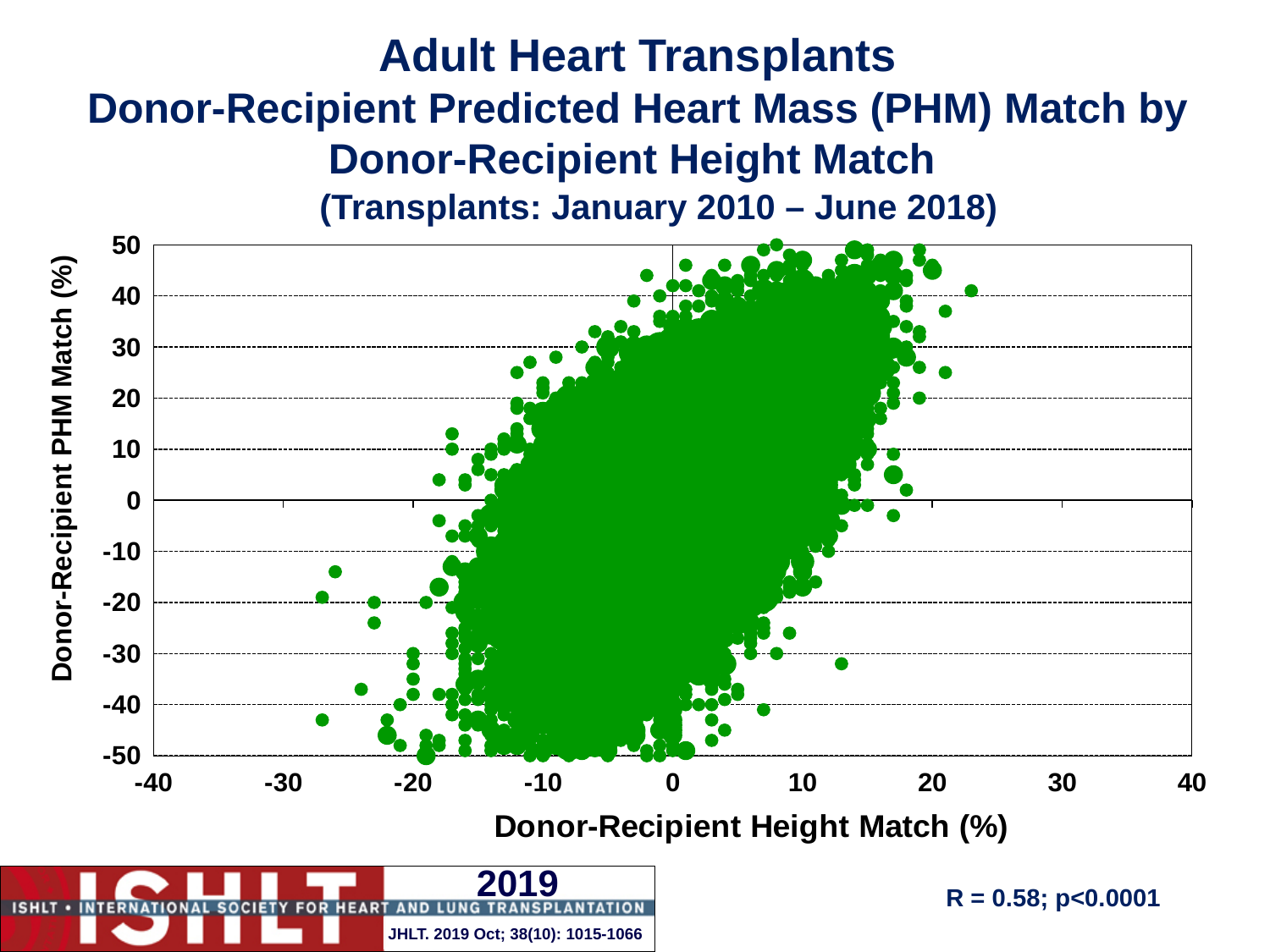
What p-value is reported on the slide for the relationship shown? p<0.0001 What is the label of the y axis? Donor-Recipient PHM Match (%) Is the correlation between height match and PHM match positive or negative? Positive What is the label of the x axis? Donor-Recipient Height Match (%) What is the highest value shown on the y axis? 50 As Donor-Recipient Height Match (%) increases along the x axis, do the Donor-Recipient PHM Match (%) values generally rise or fall? Rise What is the lowest value shown on the x axis? -40 What kind of chart is shown on the slide? Scatter plot What is the correlation coefficient R reported on the slide? R = 0.58 Over what transplant period does the chart cover, according to the title? January 2010 – June 2018